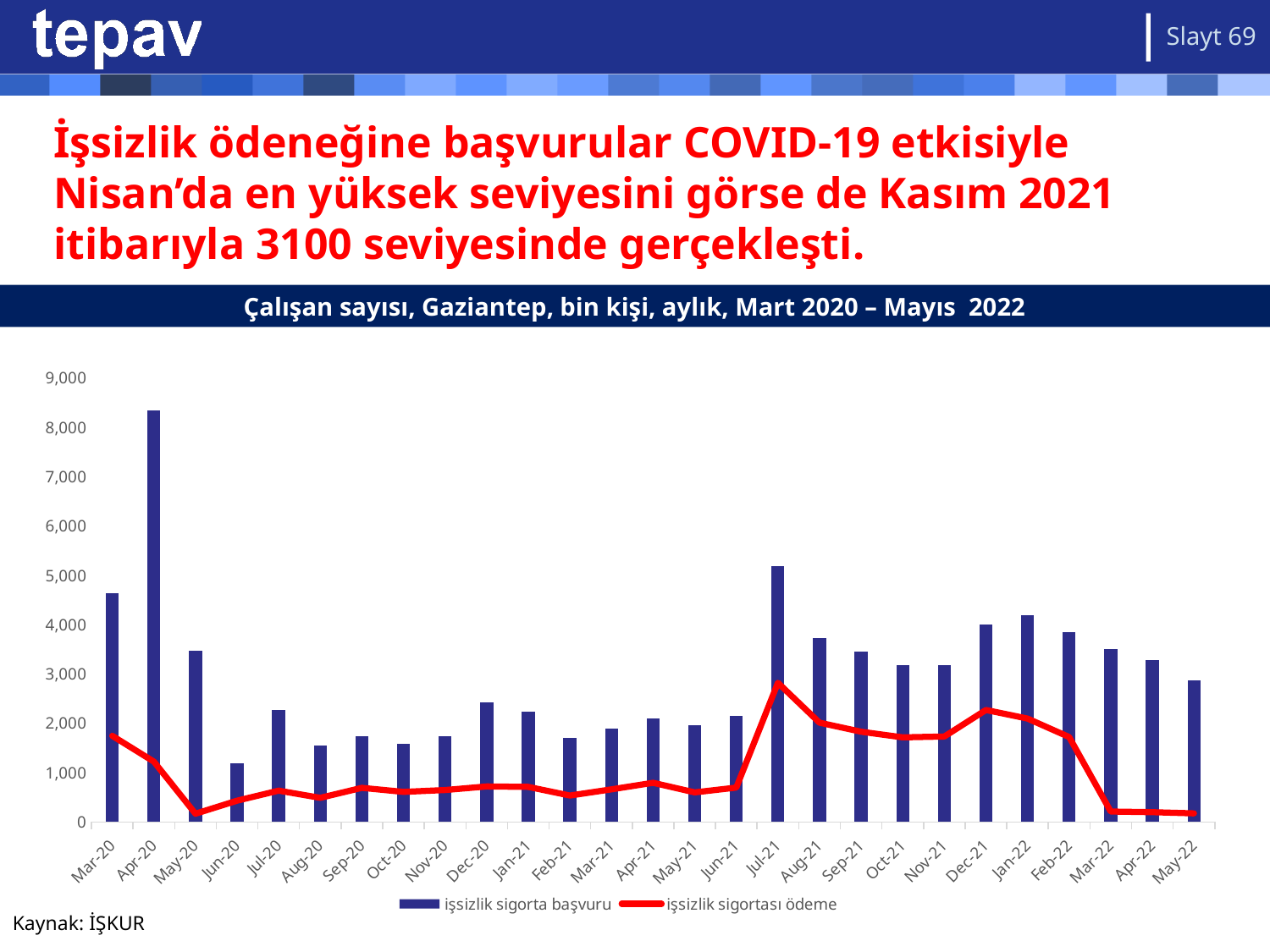
How many months are plotted along the x axis? 27 Is the işsizlik sigortası ödeme value for Mar-22 greater or less than 1,000? less Is the işsizlik sigorta başvuru value for Jul-21 greater or less than 5,000? greater In which month is the işsizlik sigorta başvuru bar lowest? Jun-20 Does the işsizlik sigortası ödeme line rise or fall from Feb-22 to Mar-22? fall What are the two series named in the legend? işsizlik sigorta başvuru and işsizlik sigortası ödeme Which is larger, the işsizlik sigorta başvuru bar for Apr-20 or for Jul-21? Apr-20 Is the işsizlik sigorta başvuru value for Apr-20 greater or less than 8,000? greater What kind of chart is shown on the slide? A combination bar and line chart In which month is the işsizlik sigorta başvuru bar highest? Apr-20 How many series does the chart legend list? 2